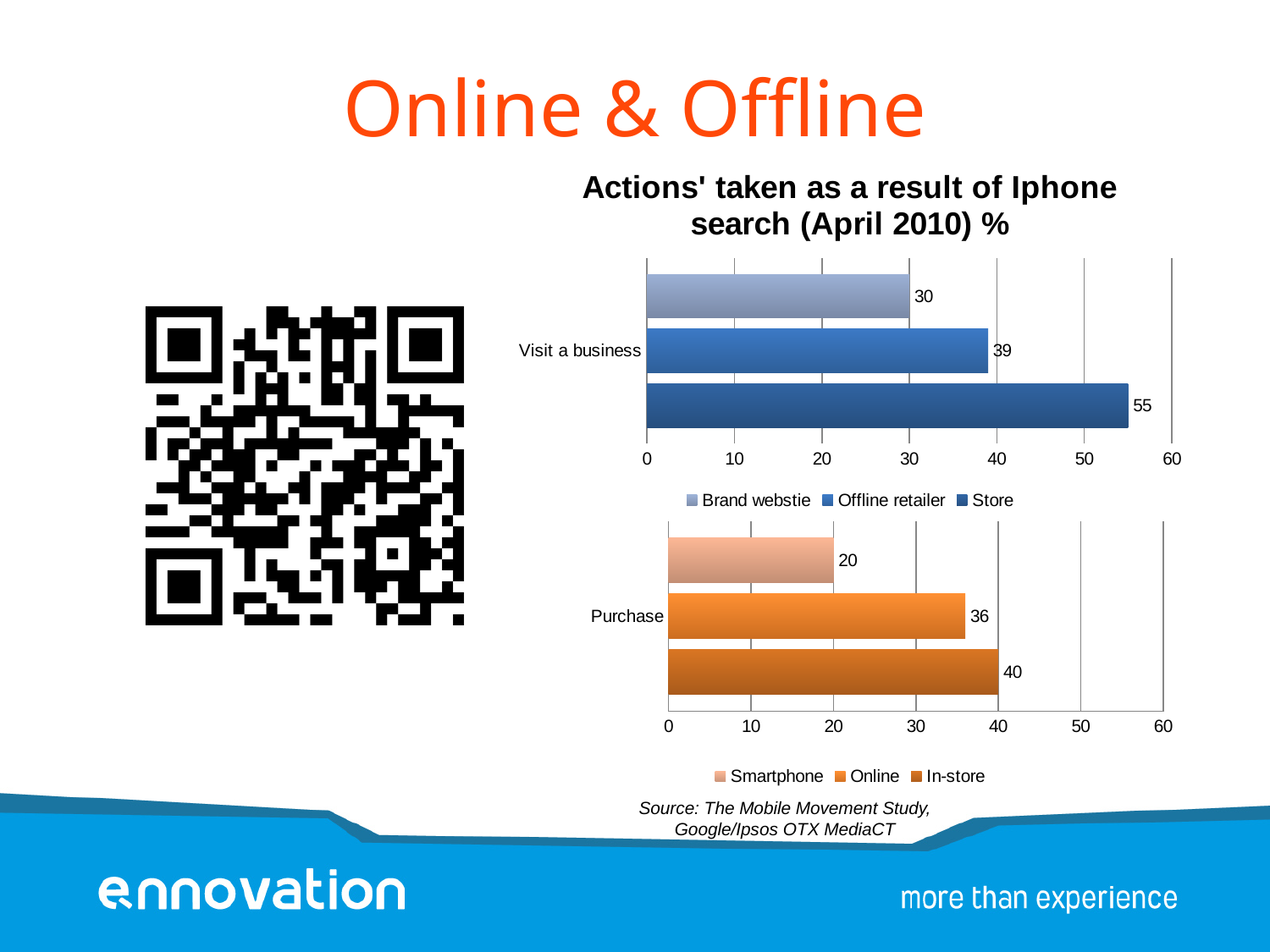
In the top chart (Visit a business), what is the value for Store? 55 What is the title shown above the top chart? Actions' taken as a result of Iphone search (April 2010) % In the bottom chart (Purchase), what is the difference between the In-store value and the Online value? 4 In the top chart (Visit a business), what is the value for Offline retailer? 39 In the bottom chart (Purchase), what is the value for Smartphone? 20 In the top chart (Visit a business), what is the difference between the Store value and the Brand webstie value? 25 In the top chart (Visit a business), which series has the highest value? Store In the bottom chart (Purchase), which is larger, the In-store value or the Smartphone value? In-store In the bottom chart (Purchase), what is the value for Online? 36 What kind of chart is the bottom chart (Purchase)? Bar chart In the bottom chart (Purchase), which series has the lowest value? Smartphone How many series does the legend of the top chart (Visit a business) list? 3